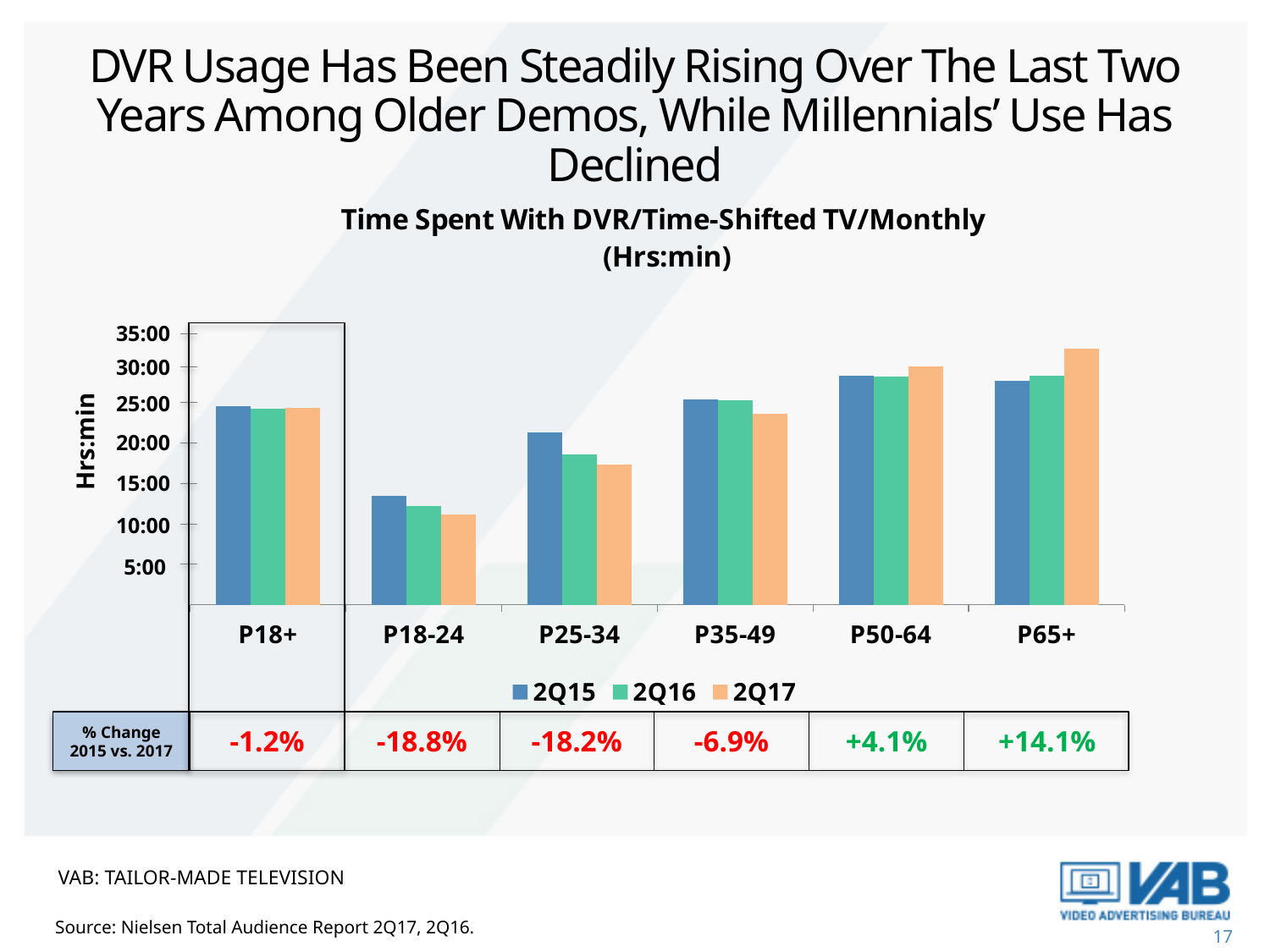
Is the 2Q17 value for P65+ greater or less than 30:00? greater How many series does the legend list? 3 What is the % change 2015 vs. 2017 shown for P65+? +14.1% Which is larger, the 2Q17 value for P65+ or the 2Q17 value for P50-64? P65+ Which demographic has the largest positive % change 2015 vs. 2017? P65+ How many demographic categories are shown on the x axis? 6 Is the 2Q15 value for P25-34 greater or less than 20:00? greater Is the 2Q17 value for P18-24 greater or less than 15:00? less For P18-24, do the values rise or fall from 2Q15 to 2Q17? fall What is the % change 2015 vs. 2017 shown for P18-24? -18.8% What kind of chart is shown on the slide? Bar chart Which demographic has the lowest % change 2015 vs. 2017? P18-24